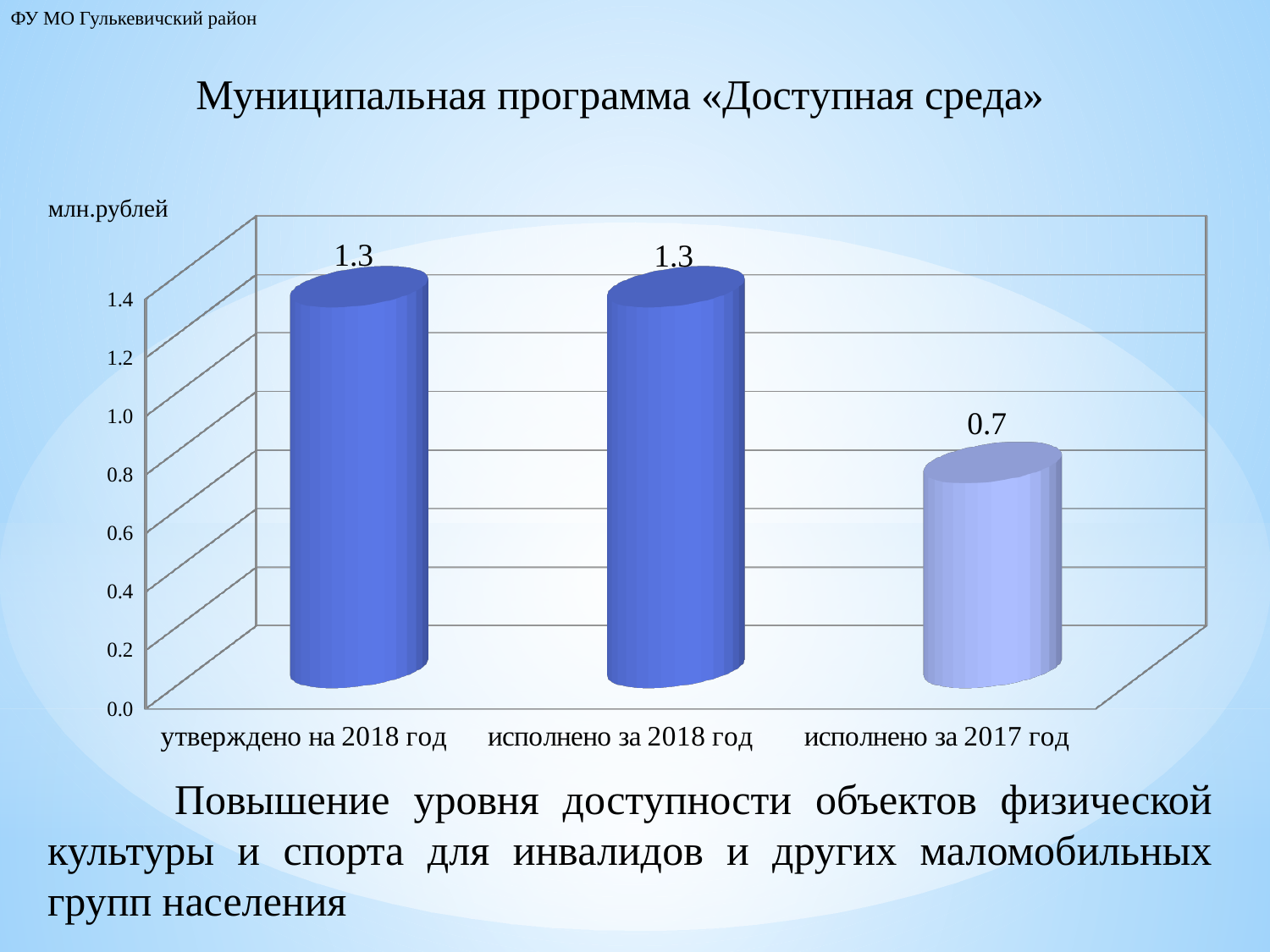
What is the value for «утверждено на 2018 год»? 1.3 What kind of chart is shown on the slide? bar chart Which category has the lowest value? исполнено за 2017 год What is the value for «исполнено за 2018 год»? 1.3 What is the difference between the value for «исполнено за 2018 год» and the value for «исполнено за 2017 год»? 0.6 What is the title of the slide containing the chart? Муниципальная программа «Доступная среда» What unit is indicated for the values on the chart? млн.рублей Is the value for «исполнено за 2017 год» greater or less than 1.0? less Which is larger: the value for «утверждено на 2018 год» or the value for «исполнено за 2017 год»? утверждено на 2018 год Is the value for «исполнено за 2018 год» greater or less than 1.0? greater How many categories are shown on the chart? 3 What is the value for «исполнено за 2017 год»? 0.7